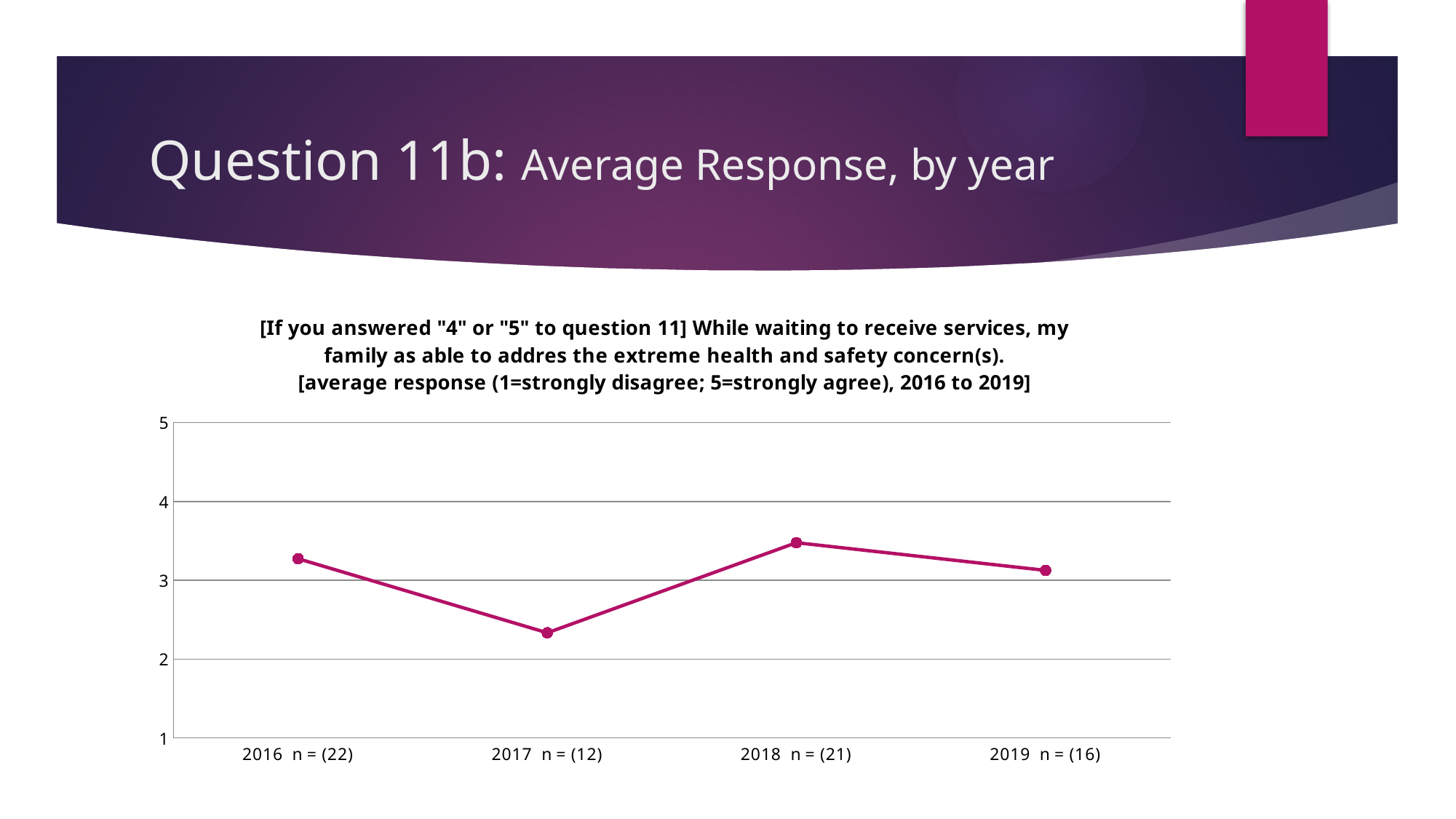
What is the sample size (n) shown for 2016 on the x axis? 22 Is the average response for 2017 greater or less than 2? greater Is the average response for 2016 greater or less than 3? greater Which year has the highest average response? 2018 Is the average response for 2018 greater or less than 4? less Which year has a higher average response, 2018 or 2019? 2018 Which year has a higher average response, 2016 or 2017? 2016 How many years (data points) are plotted on the chart? 4 What kind of chart is shown on the slide? line chart Which year has the lowest average response? 2017 Does the average response rise or fall from 2017 to 2018? rise